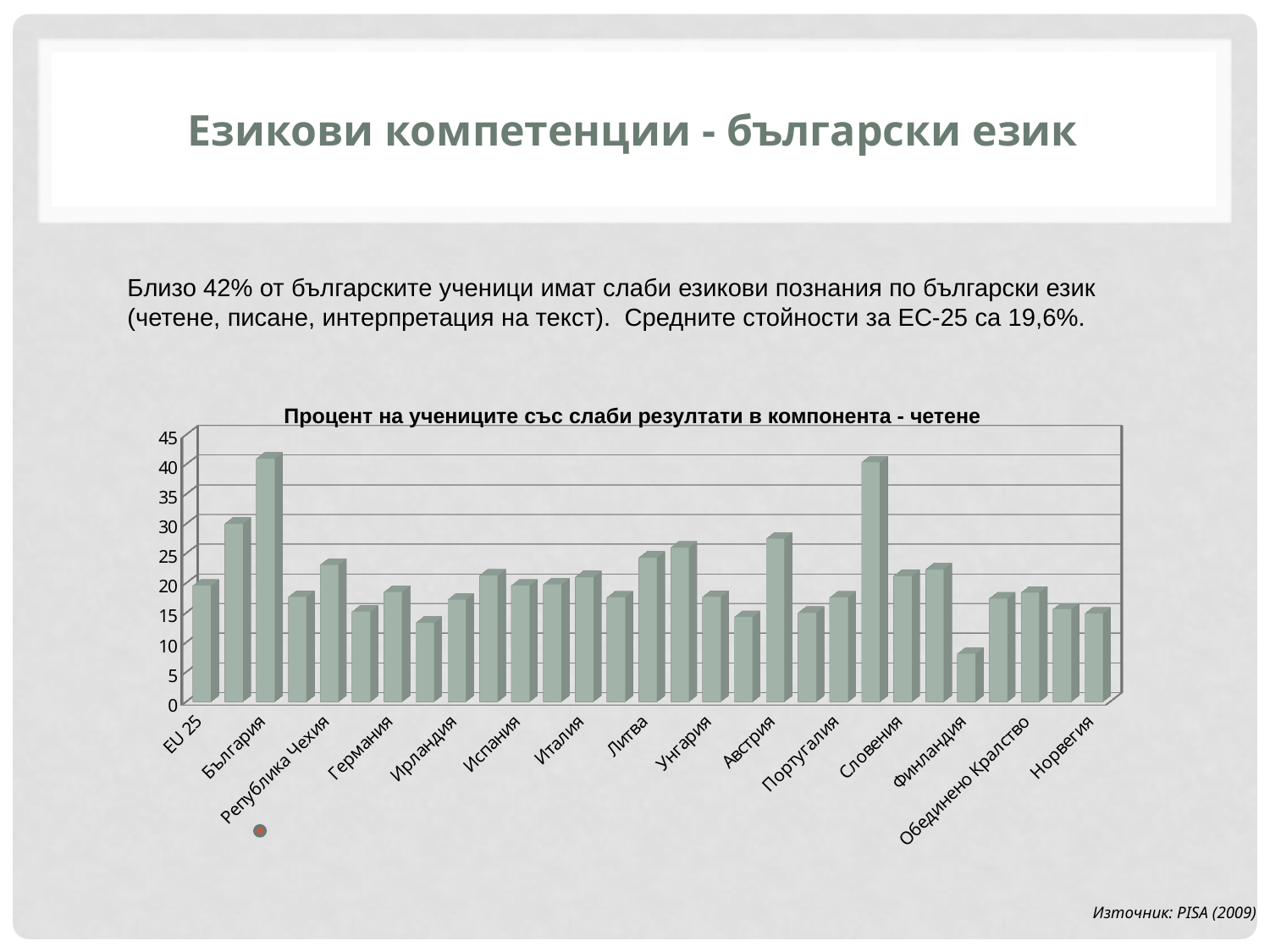
Is the value for Норвегия greater or less than 20? less What is the title of the chart? Процент на учениците със слаби резултати в компонента - четене Which is larger, the value for Австрия or the value for Португалия? Австрия What kind of chart is shown on the slide? bar chart Is the value for Финландия greater or less than 10? less Which is larger, the value for България or the value for EU 25? България Is the value for Австрия greater or less than 25? greater Which category has the lowest bar in the chart? Финландия Which is larger, the value for Финландия or the value for Норвегия? Норвегия